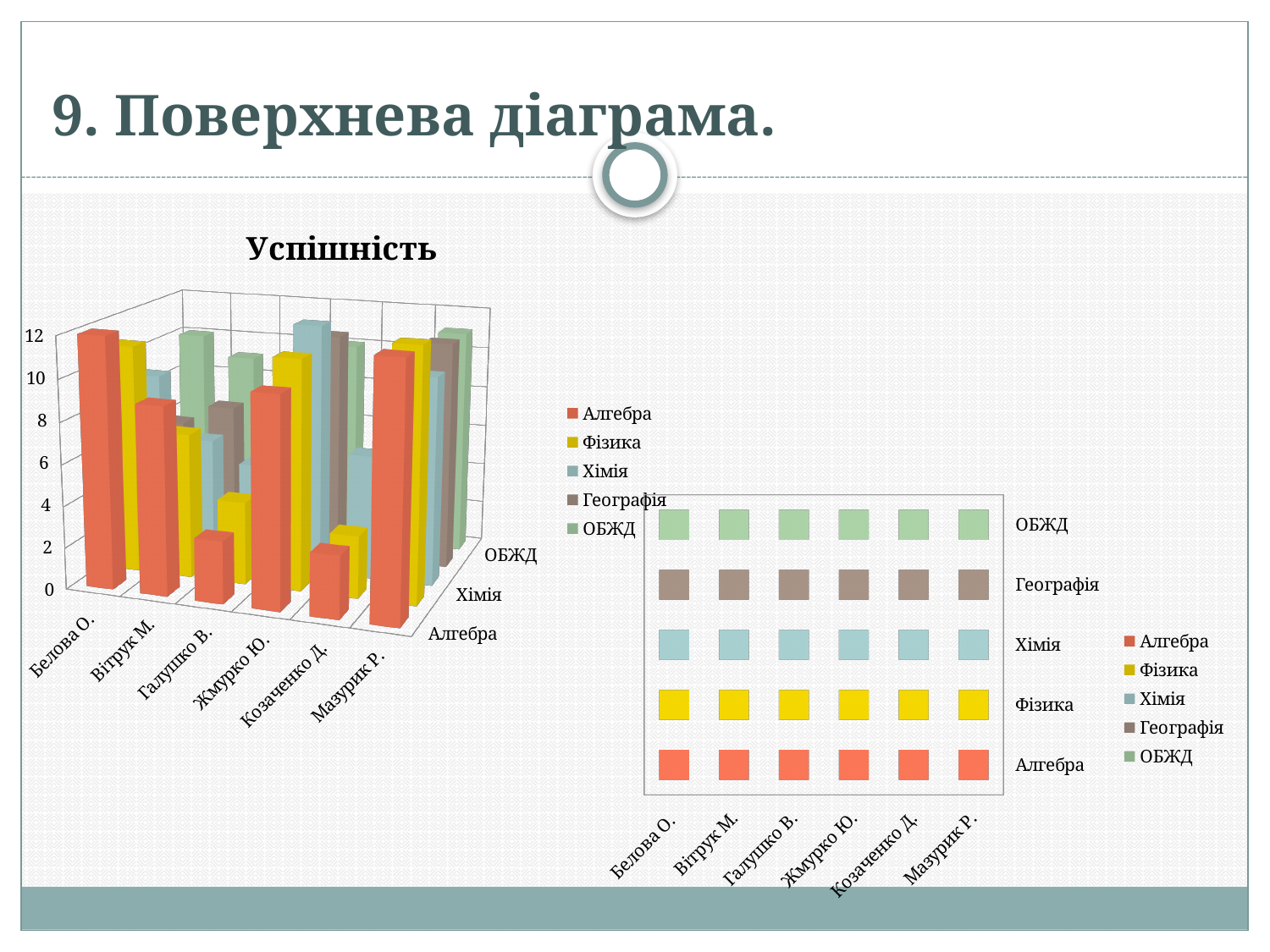
In the chart titled "Успішність", is the Алгебра value for Козаченко Д. greater or less than 6? less What kind of chart is the chart titled "Успішність" on the left? bar chart In the chart on the right, how many students are listed along the x axis? 6 In the chart titled "Успішність", how many series does the legend list? 5 In the chart titled "Успішність", is the Алгебра value for Белова О. greater or less than 8? greater In the chart titled "Успішність", which of Белова О. or Галушко В. has the larger Алгебра value? Белова О. In the chart titled "Успішність", how many students (categories) are shown along the x axis? 6 In the chart on the right, how many series does the legend list? 5 In the chart titled "Успішність", is the Алгебра value for Галушко В. greater or less than 6? less In the chart titled "Успішність", which series is shown in red? Алгебра What is the title of the chart on the left? Успішність